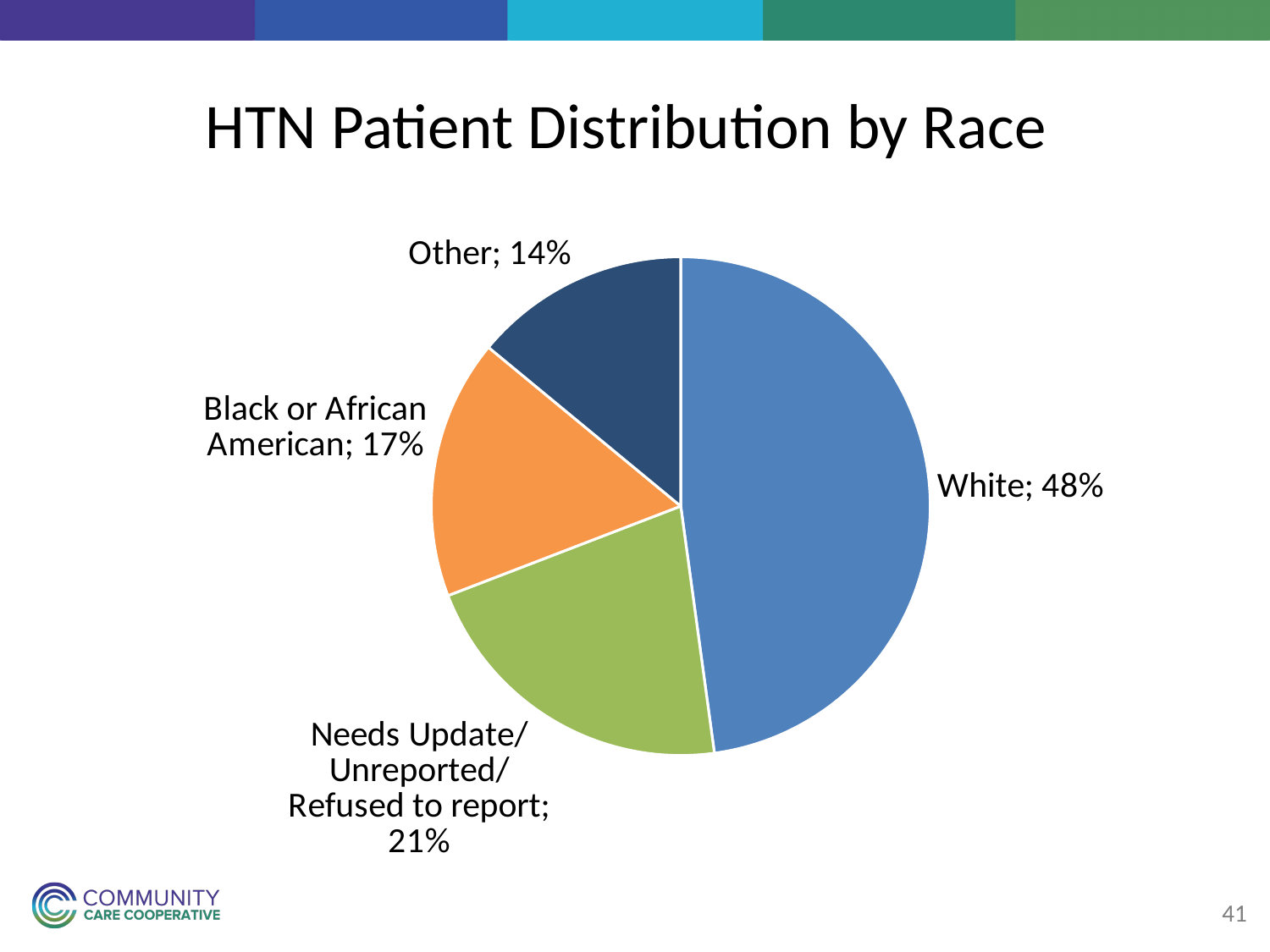
What kind of chart is shown on the slide? pie chart What is the difference in percentage points between the White share and the Black or African American share? 31 What share of HTN patients fall under Other? 14% What share of HTN patients are Black or African American? 17% Which race category has the largest share of HTN patients? White Which category has the smallest share of HTN patients? Other What share of HTN patients fall under Needs Update/Unreported/Refused to report? 21% What is the difference in percentage points between the Needs Update/Unreported/Refused to report share and the Other share? 7 What share of HTN patients are White? 48% Which is larger, the share for Black or African American or the share for Other? Black or African American How many slices does the pie chart have? 4 What is the title of the chart? HTN Patient Distribution by Race